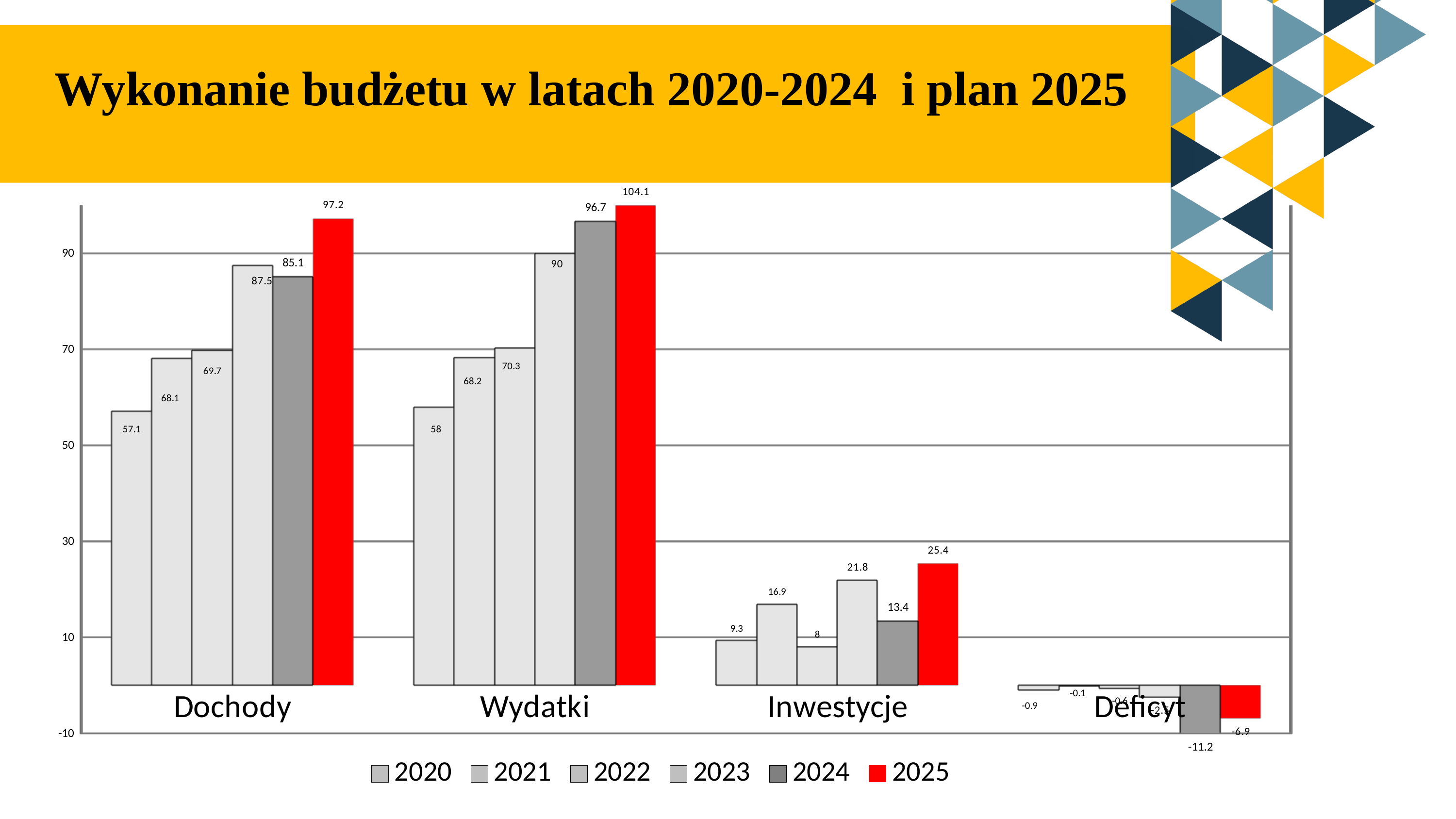
Which is larger: Dochody in 2023 or Dochody in 2024? Dochody in 2023 How many categories are shown on the x axis? 4 What is the difference between Wydatki in 2025 and Dochody in 2025? 6.9 What is the value for Inwestycje in 2022? 8 Is the value for Wydatki in 2023 greater or less than 70? greater What kind of chart is shown on the slide? bar chart What is the value for Dochody in 2025? 97.2 What is the value for Deficyt in 2024? -11.2 Which year has the highest value for Inwestycje? 2025 What is the value for Wydatki in 2024? 96.7 How many series does the legend list? 6 Which year has the lowest value for Dochody? 2020